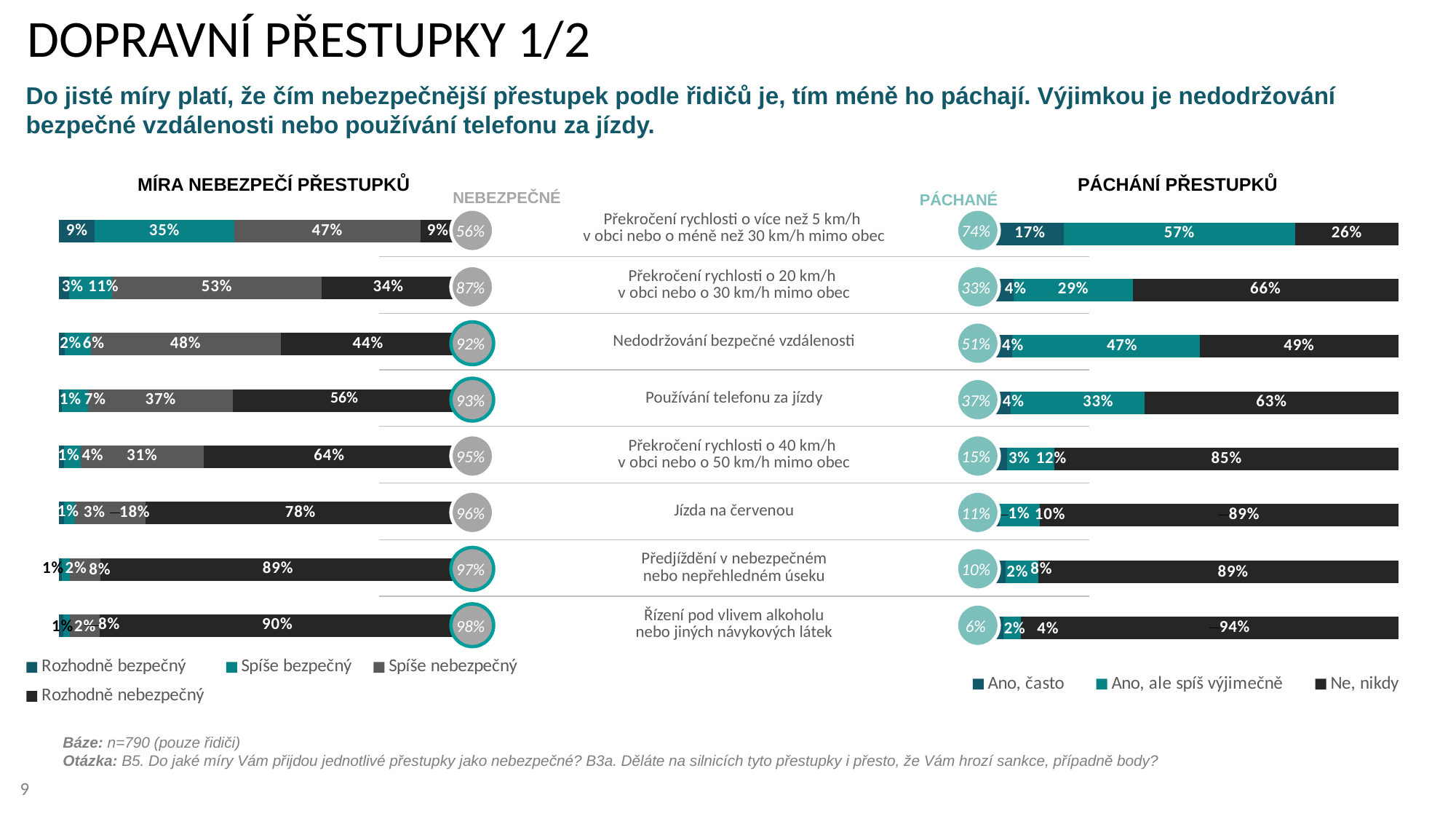
How many series does the legend of the MÍRA NEBEZPEČÍ PŘESTUPKŮ chart list? 4 In the MÍRA NEBEZPEČÍ PŘESTUPKŮ chart, which is larger: the 'Spíše bezpečný' value for 'Překročení rychlosti o více než 5 km/h v obci nebo o méně než 30 km/h mimo obec' or for 'Překročení rychlosti o 20 km/h v obci nebo o 30 km/h mimo obec'? Překročení rychlosti o více než 5 km/h v obci nebo o méně než 30 km/h mimo obec What is the PÁCHANÉ value shown in the circle for 'Překročení rychlosti o 40 km/h v obci nebo o 50 km/h mimo obec'? 15% What kind of chart is the PÁCHÁNÍ PŘESTUPKŮ chart? Stacked bar chart In the PÁCHÁNÍ PŘESTUPKŮ chart, which category has the lowest 'Ne, nikdy' value? Překročení rychlosti o více než 5 km/h v obci nebo o méně než 30 km/h mimo obec In the PÁCHÁNÍ PŘESTUPKŮ chart, what is the value of 'Ano, ale spíš výjimečně' for 'Nedodržování bezpečné vzdálenosti'? 47% How many categories does the PÁCHÁNÍ PŘESTUPKŮ chart show? 8 In the PÁCHÁNÍ PŘESTUPKŮ chart, what is the value of 'Ne, nikdy' for 'Řízení pod vlivem alkoholu nebo jiných návykových látek'? 94% What is the NEBEZPEČNÉ value shown in the circle for 'Jízda na červenou'? 96% In the MÍRA NEBEZPEČÍ PŘESTUPKŮ chart, what is the value of 'Spíše nebezpečný' for 'Překročení rychlosti o 20 km/h v obci nebo o 30 km/h mimo obec'? 53% In the MÍRA NEBEZPEČÍ PŘESTUPKŮ chart, which category has the highest 'Rozhodně nebezpečný' value? Řízení pod vlivem alkoholu nebo jiných návykových látek In the PÁCHÁNÍ PŘESTUPKŮ chart, what is the difference between the 'Ne, nikdy' values for 'Používání telefonu za jízdy' and 'Nedodržování bezpečné vzdálenosti'? 14%